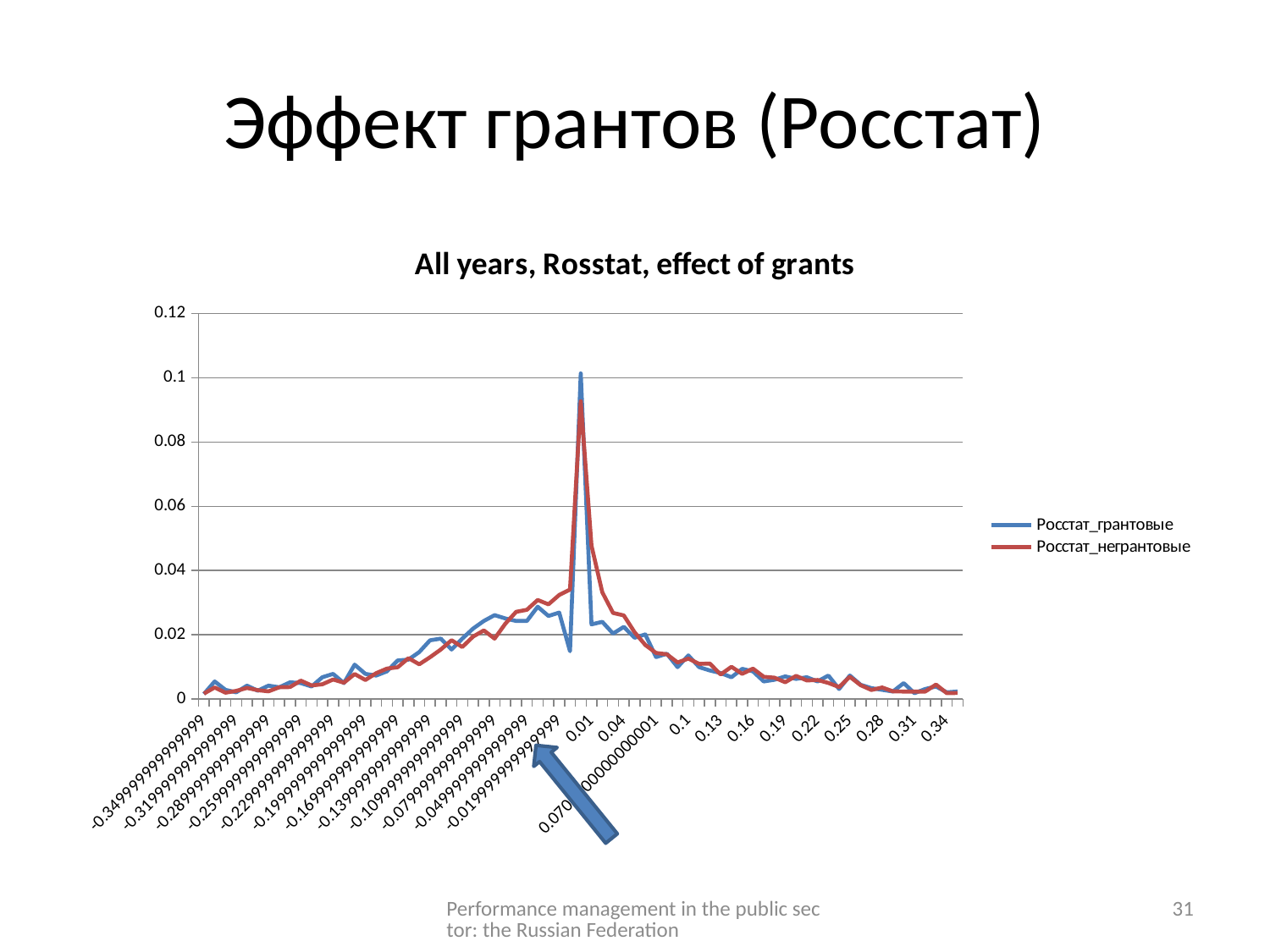
What kind of chart is shown on the slide? line chart Moving along the x axis from 0.01 to 0.34, do the values of the Росстат_негрантовые series generally rise or fall? fall What is the title of the chart? All years, Rosstat, effect of grants Moving along the x axis from -0.349999999999999 to 0.01, do the values of the Росстат_грантовые series generally rise or fall? rise Is the value for Росстат_грантовые at 0.34 greater or less than 0.02? less Is the value for Росстат_негрантовые at 0.1 greater or less than 0.04? less What are the two series named in the legend? Росстат_грантовые and Росстат_негрантовые Is the value for Росстат_грантовые at 0.01 greater or less than 0.08? less How many series does the legend list? 2